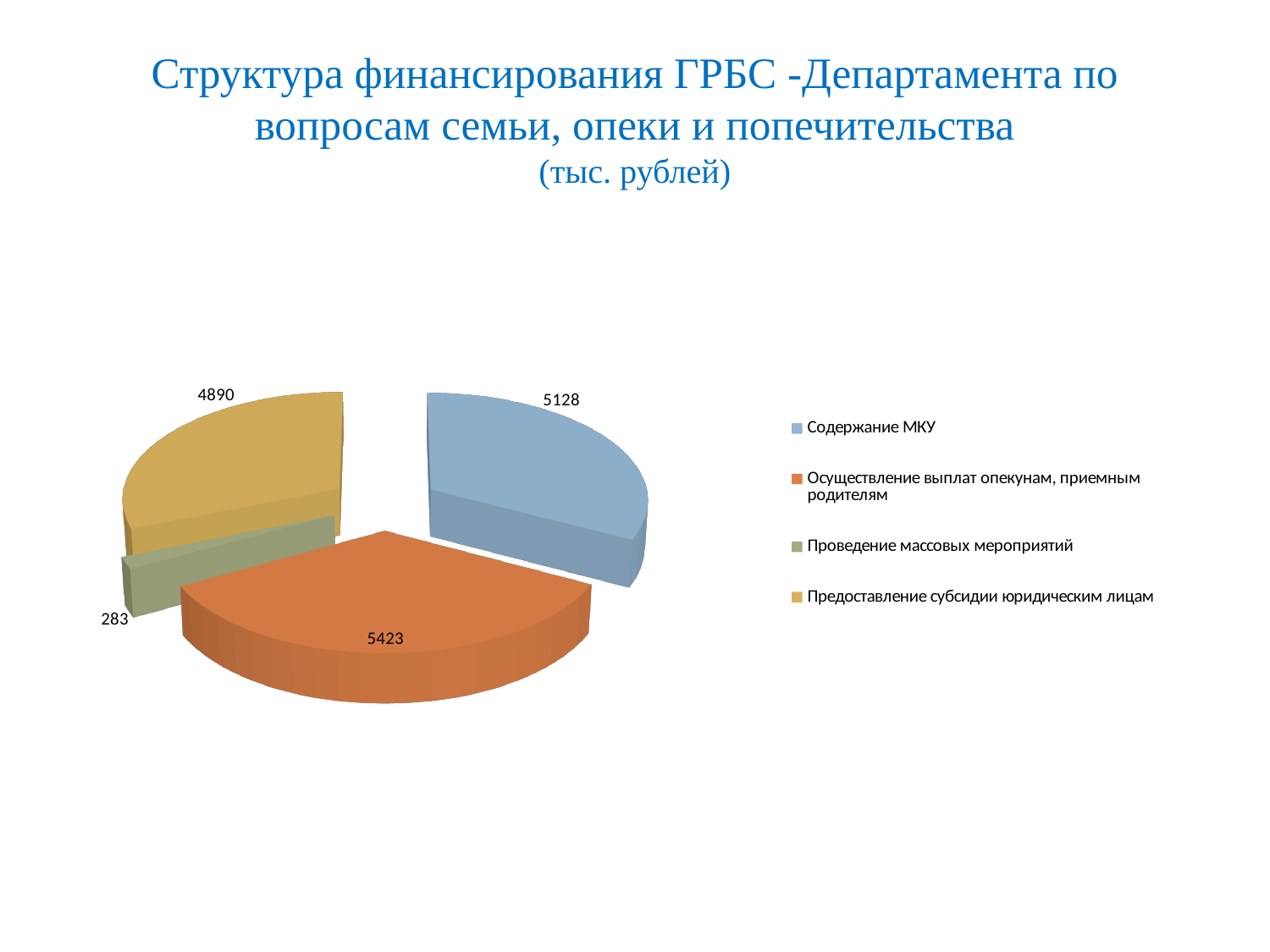
How many categories does the pie chart show? 4 What is the value for Проведение массовых мероприятий? 283 What colour is the slice for Предоставление субсидии юридическим лицам? Yellow What is the value for Осуществление выплат опекунам, приемным родителям? 5423 What is the value for Предоставление субсидии юридическим лицам? 4890 What type of chart is shown on the slide? Pie chart Which is larger: the value for Содержание МКУ or the value for Предоставление субсидии юридическим лицам? Содержание МКУ What is the total of all the slices in the pie chart? 15724 What is the value for Содержание МКУ? 5128 What is the difference between the values for Осуществление выплат опекунам, приемным родителям and Содержание МКУ? 295 Which category has the smallest value? Проведение массовых мероприятий Which category has the largest value? Осуществление выплат опекунам, приемным родителям